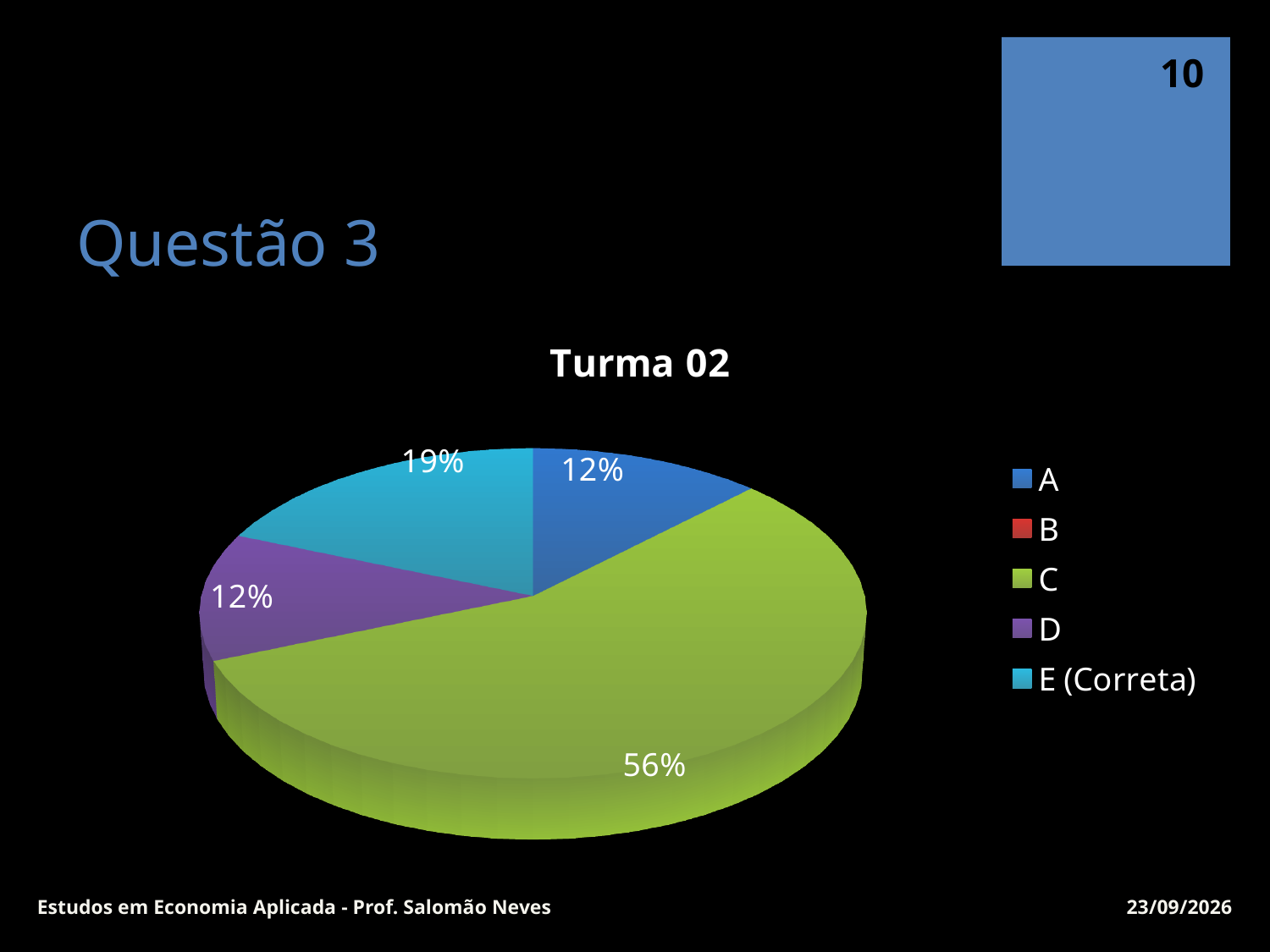
What is the difference in percentage points between the slices for E (Correta) and D? 7 What kind of chart is shown on the slide? pie chart Which is larger, the slice for E (Correta) or the slice for A? E (Correta) Which category has the largest slice of the pie? C What share of the pie does category A have? 12% How many entries does the chart legend list? 5 Which legend entry is marked as the correct answer? E (Correta) What is the difference in percentage points between the slices for C and E (Correta)? 37 What is the title of the chart? Turma 02 What share of the pie does category E (Correta) have? 19% What share of the pie does category D have? 12%